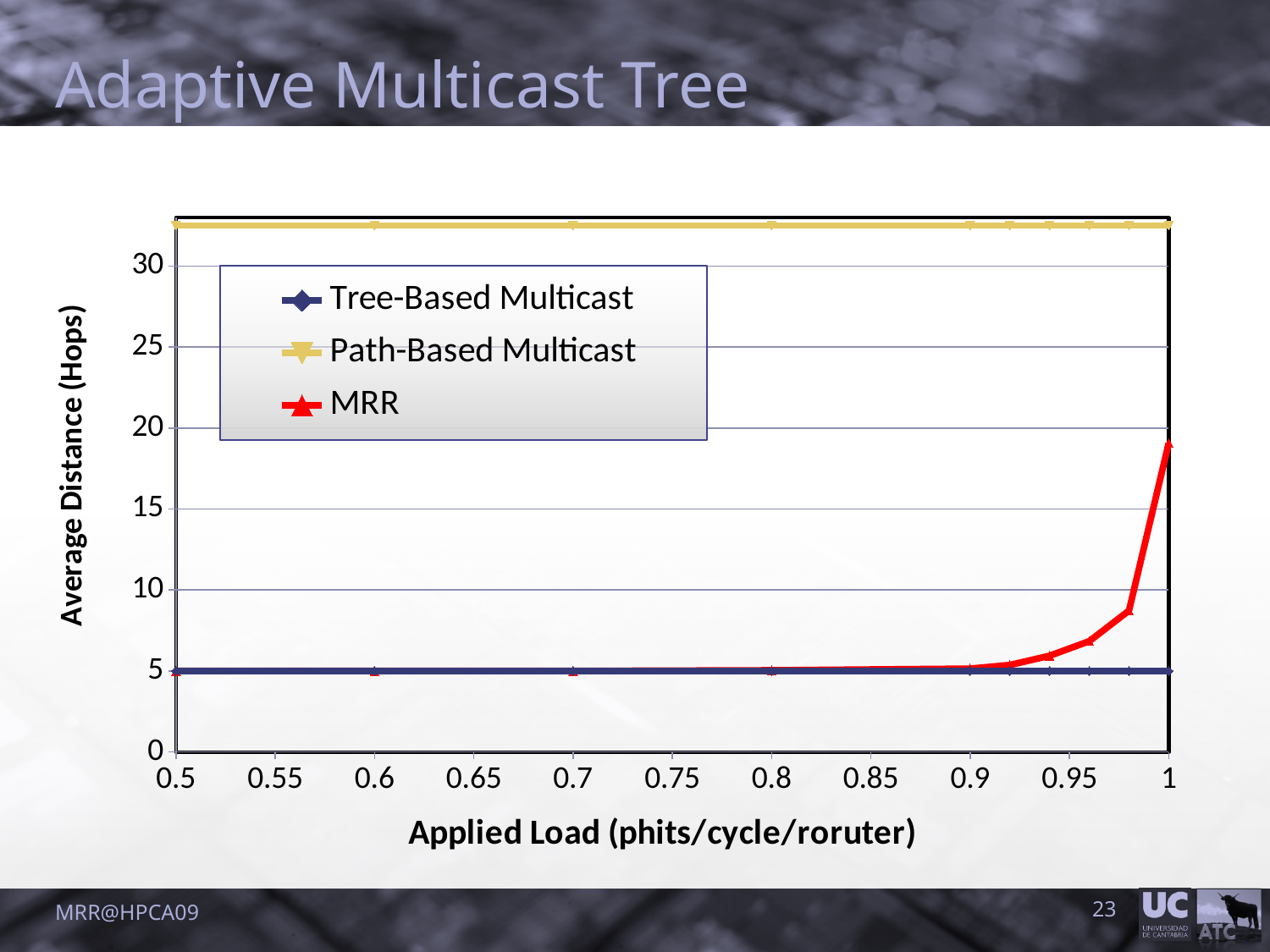
Is the value for MRR at an applied load of 0.8 greater or less than 10? less How many tick labels are shown on the x axis? 11 At an applied load of 0.9, which is larger: Path-Based Multicast or MRR? Path-Based Multicast Does the MRR series rise or fall as applied load increases from 0.9 to 1? rise Is the value for MRR at an applied load of 1 greater or less than 15? greater How many series does the legend list? 3 Is the value for Tree-Based Multicast at an applied load of 0.7 greater or less than 10? less What is the title of the x axis? Applied Load (phits/cycle/roruter) Which series has the highest average distance across the whole load range? Path-Based Multicast What kind of chart is shown on the slide? line chart What is the title of the y axis? Average Distance (Hops)